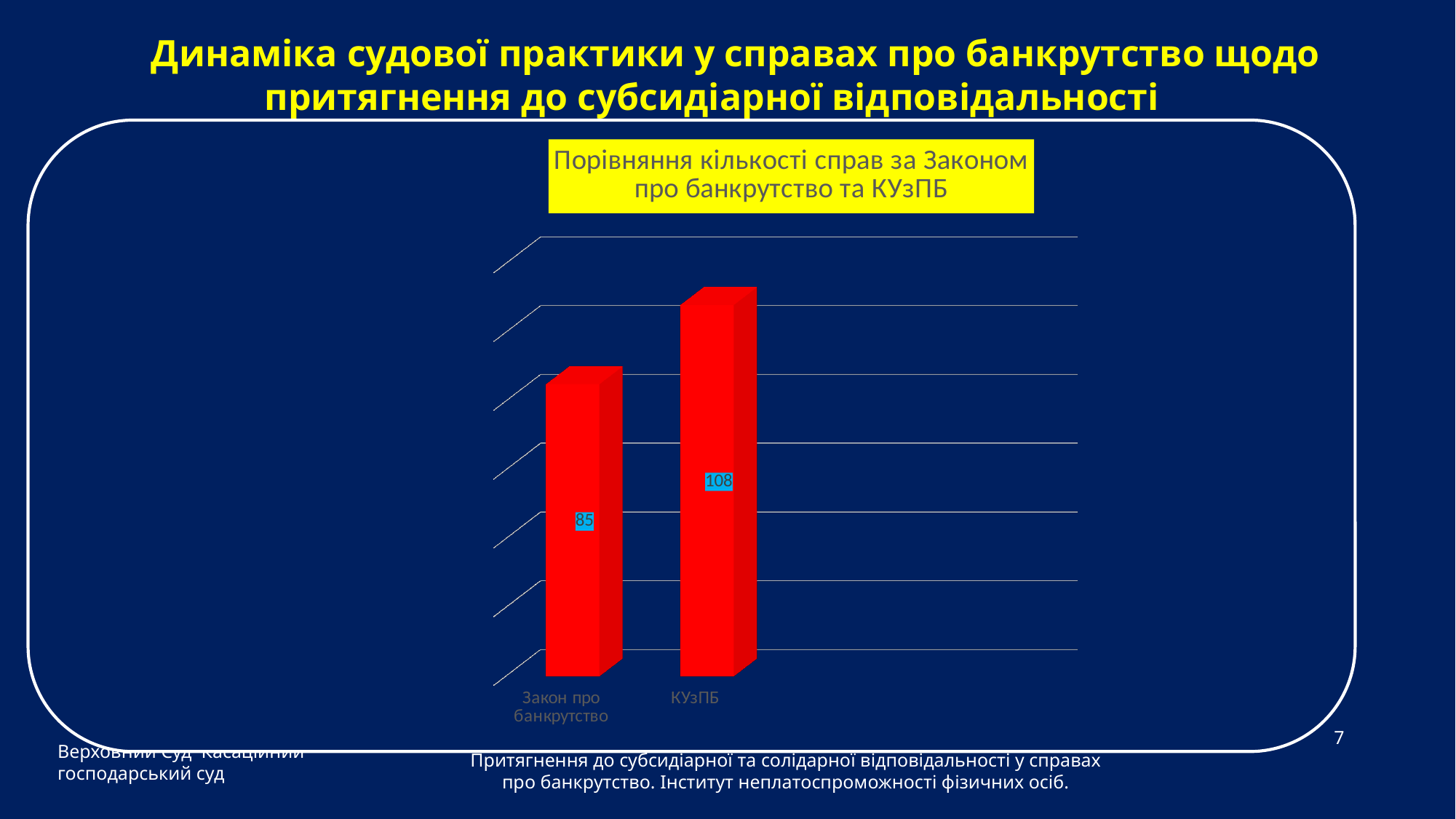
What is the value for "КУзПБ"? 108 Which is larger, the value for "Закон про банкрутство" or the value for "КУзПБ"? КУзПБ Which category has the lowest value? Закон про банкрутство What kind of chart is shown on the slide? Bar chart What is the title of the chart? Порівняння кількості справ за Законом про банкрутство та КУзПБ What is the value for "Закон про банкрутство"? 85 Do the values rise or fall from left to right along the x axis? Rise How many categories are shown in the chart? 2 What colour are the bars in the chart? Red Which category has the highest value? КУзПБ What is the difference between the values for "КУзПБ" and "Закон про банкрутство"? 23